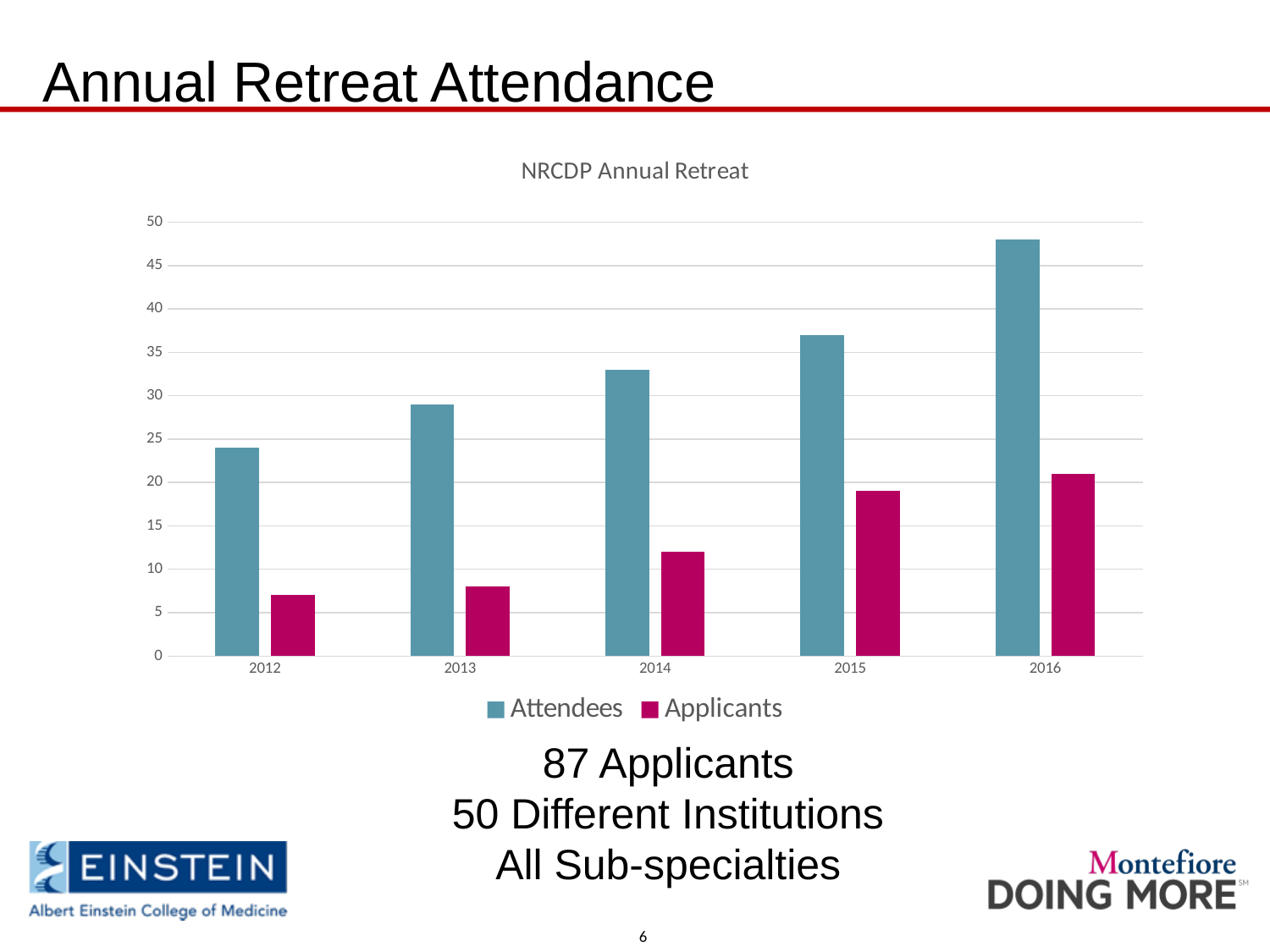
Is the value for Attendees in 2016 greater or less than 45? greater Which is larger in 2015, Attendees or Applicants? Attendees How many series does the legend list? 2 Which year has the lowest number of Applicants? 2012 What is the title of the chart? NRCDP Annual Retreat How many years are shown on the x axis? 5 Is the value for Applicants in 2012 greater or less than 10? less Is the value for Attendees in 2014 greater or less than 30? greater Which series is shown in the magenta bars? Applicants What kind of chart is shown on the slide? bar chart Do the Attendees values rise or fall from 2012 to 2016? rise Which year has the highest number of Attendees? 2016